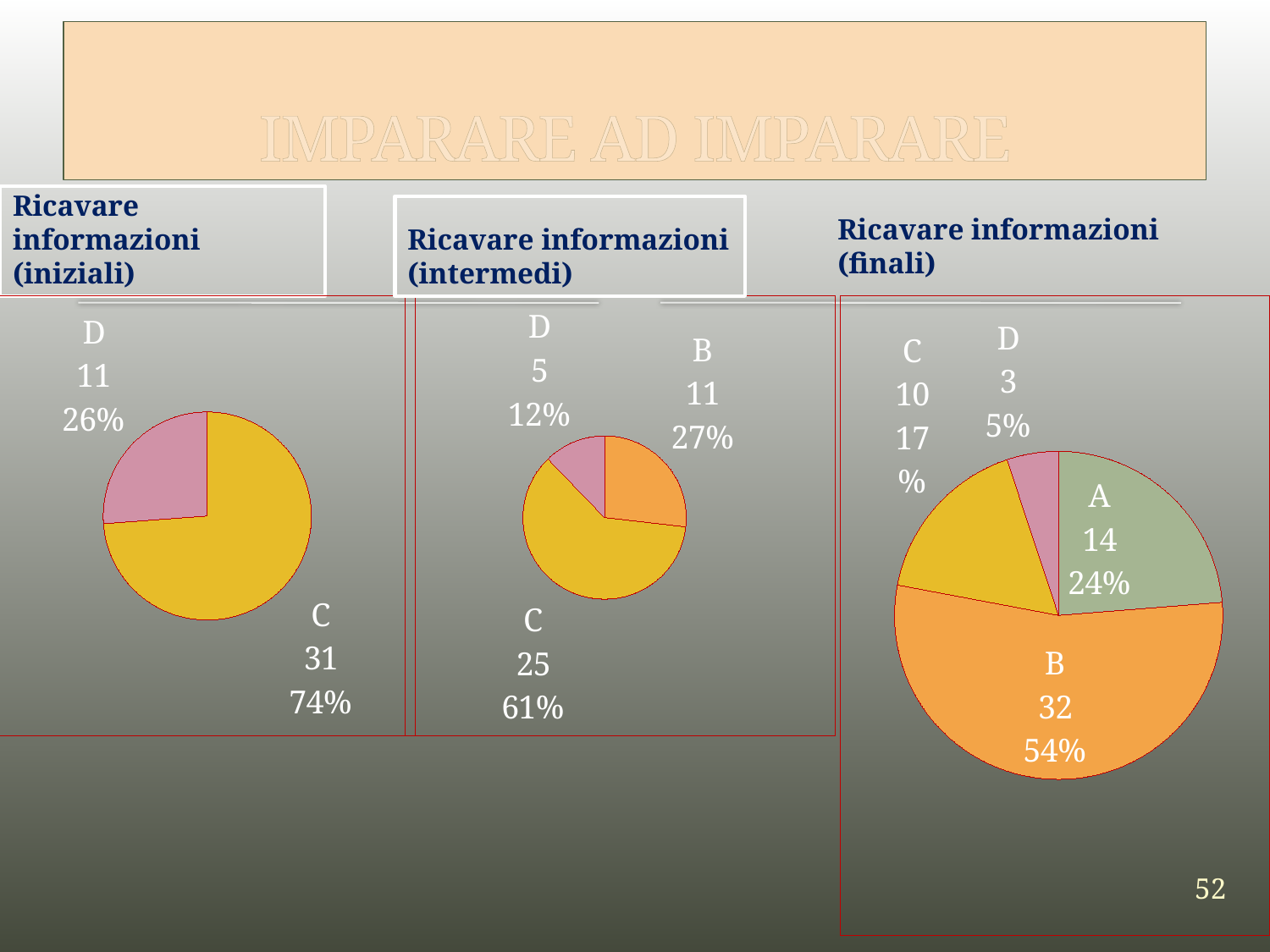
In the 'Ricavare informazioni (intermedi)' chart, which category has the smallest slice? D How many slices does the 'Ricavare informazioni (finali)' pie chart have? 4 In the 'Ricavare informazioni (intermedi)' chart, what share of the pie does C represent? 61% In the 'Ricavare informazioni (iniziali)' chart, what share of the pie does D represent? 26% In the 'Ricavare informazioni (intermedi)' chart, what is the difference between the values for C and D? 20 In the 'Ricavare informazioni (finali)' chart, which category has the largest slice? B In the 'Ricavare informazioni (intermedi)' chart, what is the value for B? 11 How many slices does the 'Ricavare informazioni (iniziali)' pie chart have? 2 What type of chart is used for 'Ricavare informazioni (finali)'? Pie chart In the 'Ricavare informazioni (finali)' chart, which is larger, the value for C or the value for A? A In the 'Ricavare informazioni (iniziali)' chart, what is the value for C? 31 In the 'Ricavare informazioni (finali)' chart, what is the value for A? 14